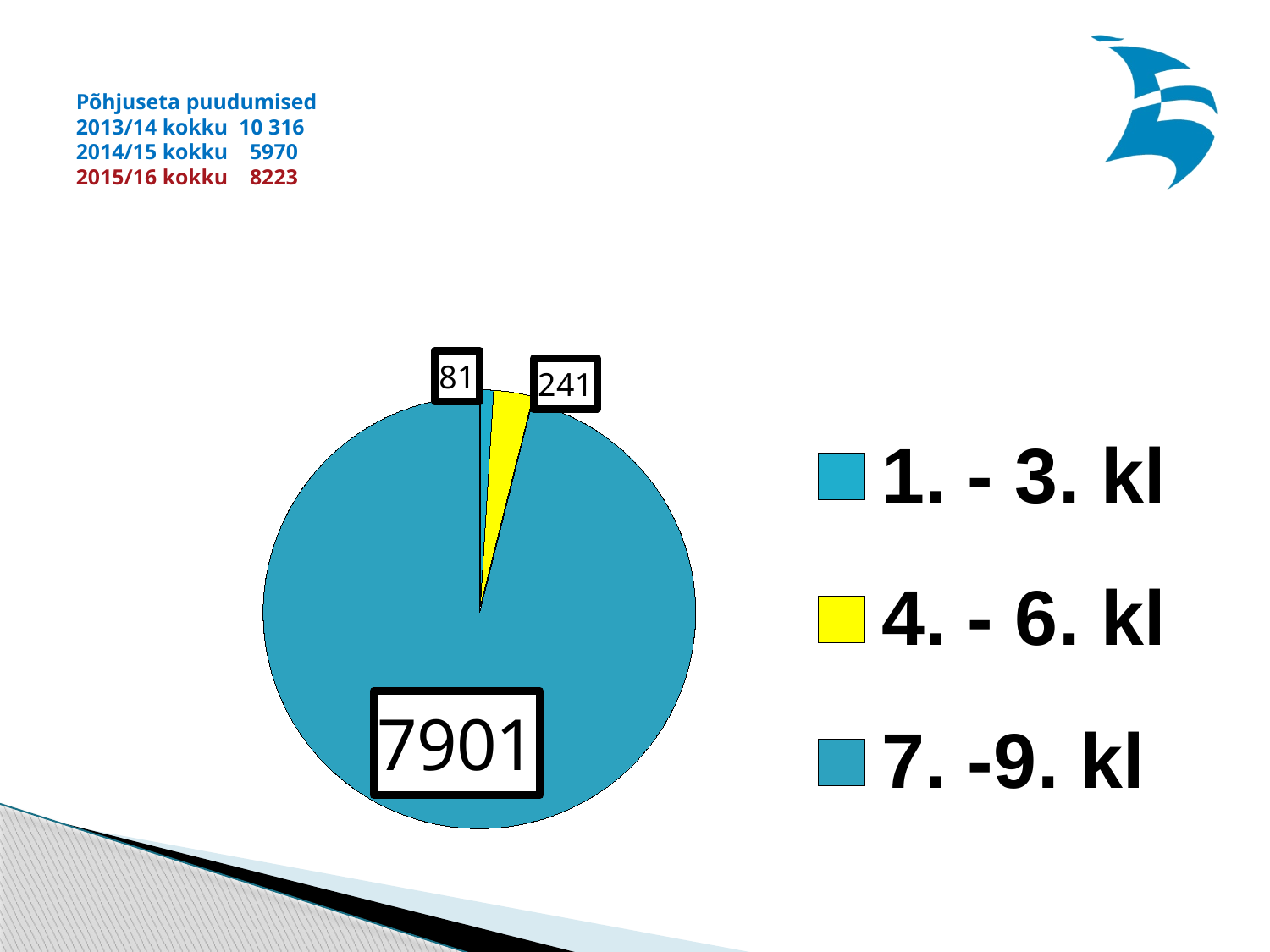
What is the value for 7. -9. kl in the pie chart? 7901 What is the difference between the values for 7. -9. kl and 4. - 6. kl? 7660 Which category has the smallest slice in the pie chart? 1. - 3. kl What is the total of all slices in the pie chart? 8223 How many slices does the pie chart have? 3 What kind of chart is shown on the slide? pie chart Which category has the largest slice in the pie chart? 7. -9. kl What is the value for 4. - 6. kl in the pie chart? 241 Which is larger, the value for 4. - 6. kl or the value for 1. - 3. kl? 4. - 6. kl What colour is the slice for 4. - 6. kl in the pie chart? yellow What is the value for 1. - 3. kl in the pie chart? 81 What is the difference between the values for 4. - 6. kl and 1. - 3. kl? 160